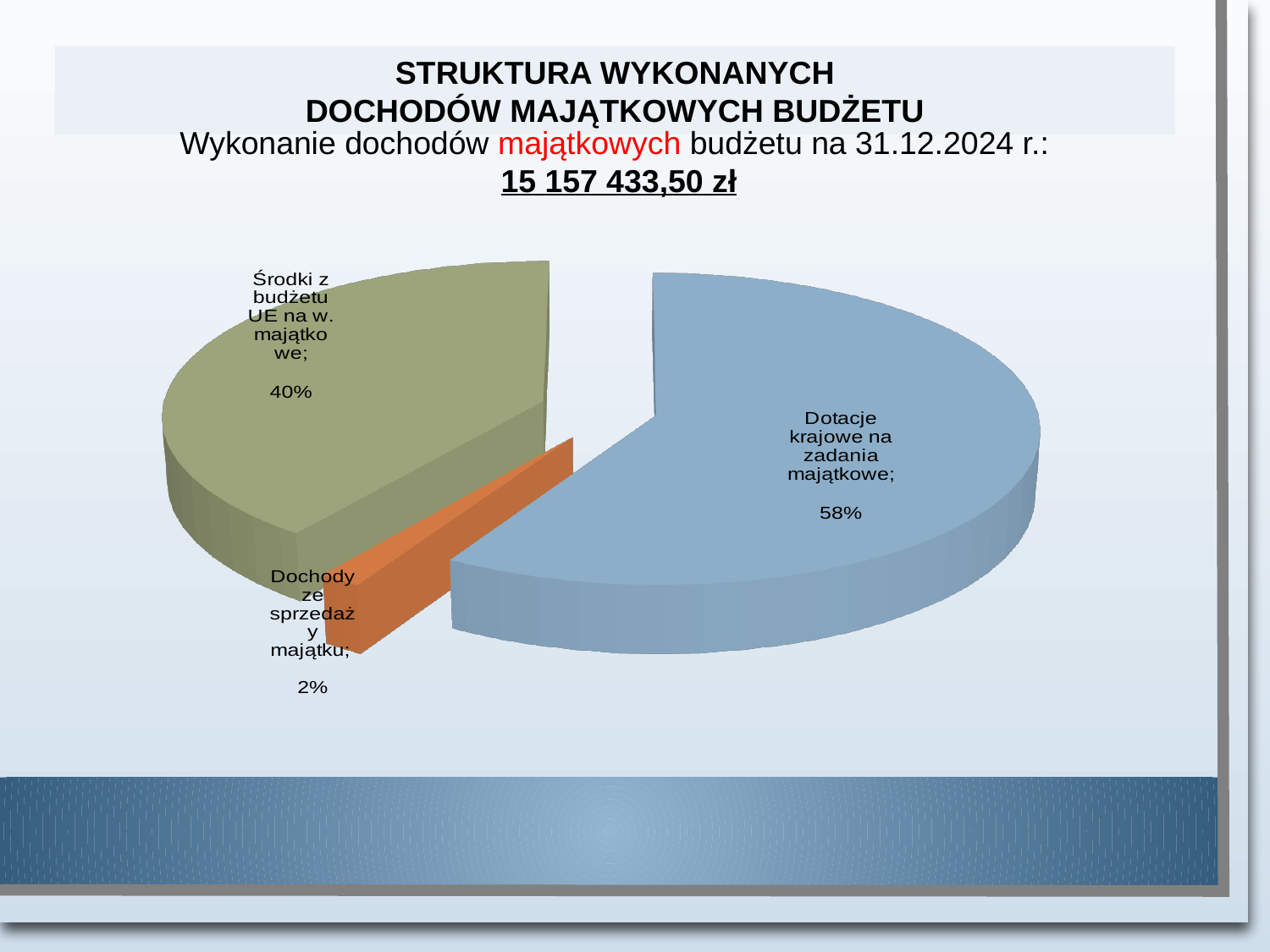
What is the difference in percentage points between "Dotacje krajowe na zadania majątkowe" and "Środki z budżetu UE na w. majątkowe"? 18 percentage points What share of the pie is "Dochody ze sprzedaży majątku"? 2% Which slice of the pie chart is the largest? Dotacje krajowe na zadania majątkowe What total amount of executed capital revenues as of 31.12.2024 is stated above the chart? 15 157 433,50 zł Which slice of the pie chart is the smallest? Dochody ze sprzedaży majątku How many slices does the pie chart have? 3 What share of the pie is "Dotacje krajowe na zadania majątkowe"? 58% Which is larger: the share for "Środki z budżetu UE na w. majątkowe" or the share for "Dochody ze sprzedaży majątku"? Środki z budżetu UE na w. majątkowe What kind of chart is shown on the slide? pie chart What is the combined share of "Środki z budżetu UE na w. majątkowe" and "Dochody ze sprzedaży majątku"? 42% What share of the pie is "Środki z budżetu UE na w. majątkowe"? 40% What colour is the slice for "Dochody ze sprzedaży majątku"? orange